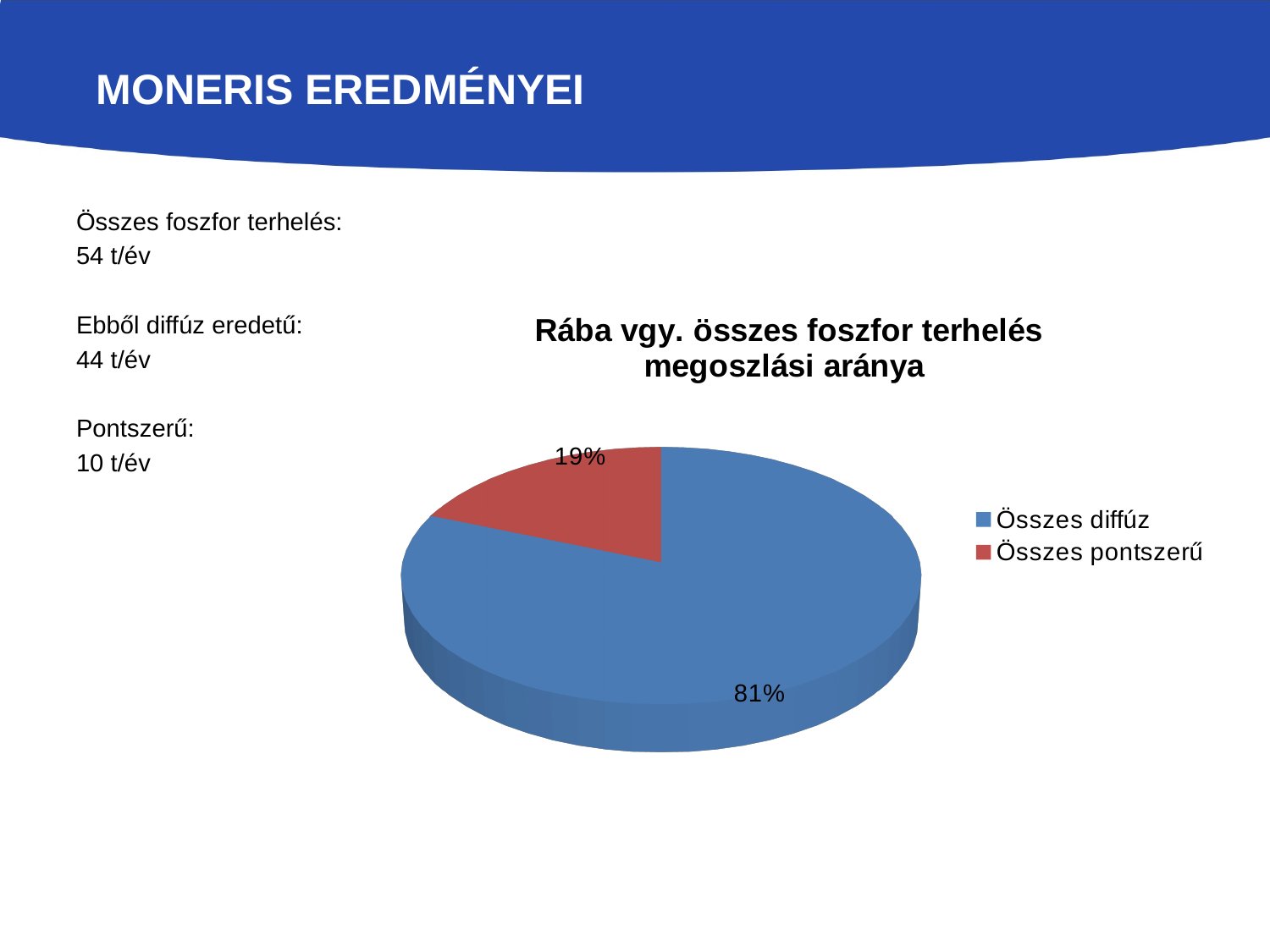
How many slices does the pie chart have? 2 Which is larger, the Összes diffúz slice or the Összes pontszerű slice? Összes diffúz What share of the pie does Összes pontszerű have? 19% What is the difference in percentage points between the Összes diffúz and Összes pontszerű slices? 62 Which slice is the smallest? Összes pontszerű What colour is the Összes pontszerű slice? red What kind of chart is shown on the slide? pie chart What share of the pie does Összes diffúz have? 81% Which slice is the largest? Összes diffúz How many entries does the legend list? 2 What is the title of the chart? Rába vgy. összes foszfor terhelés megoszlási aránya